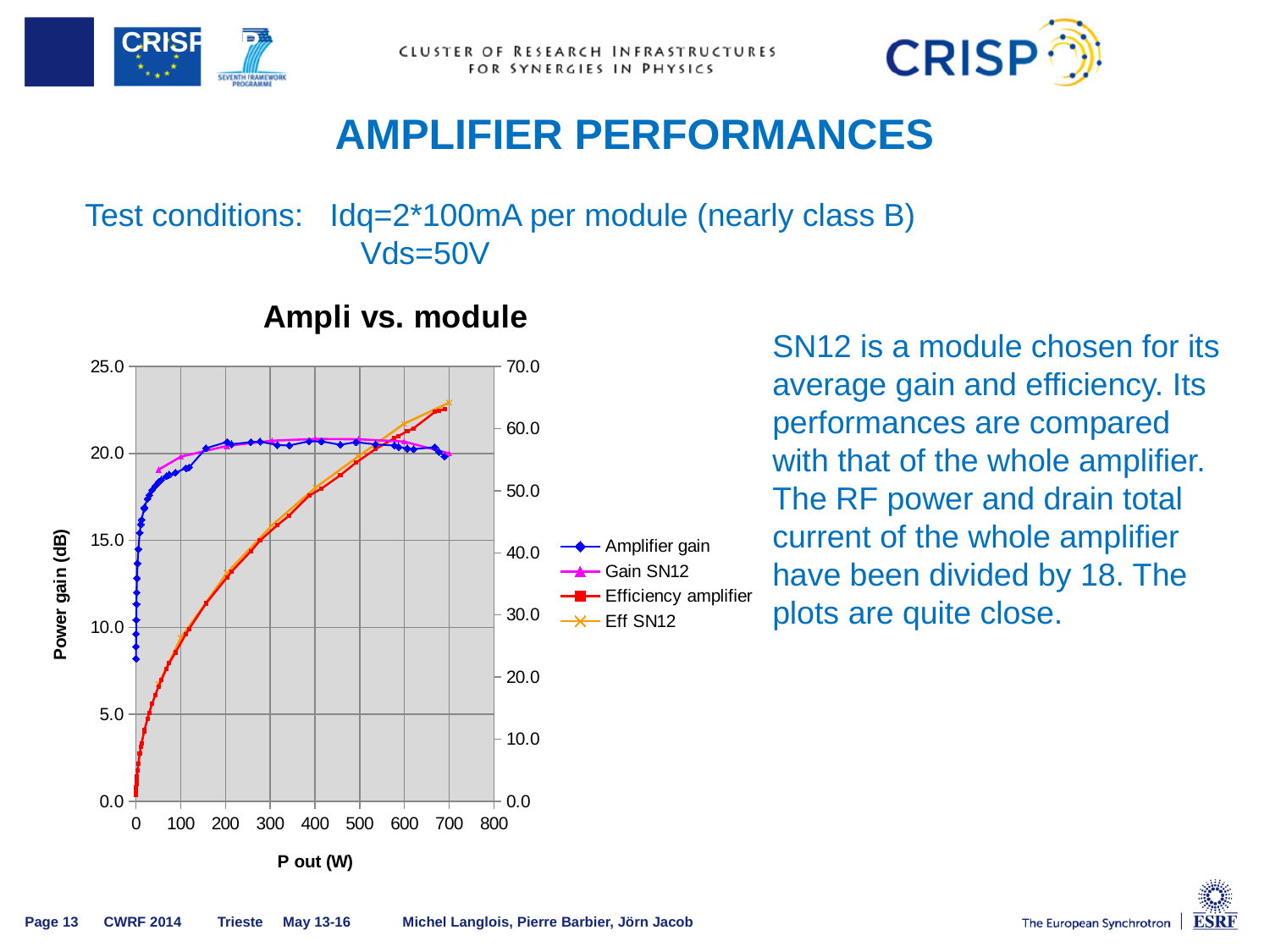
What is the title of the chart? Ampli vs. module Does the Eff SN12 series rise or fall as P out increases? rises Is the Amplifier gain value at 400 W greater or less than 15.0 dB? greater Is the Efficiency amplifier value at 700 W greater or less than 50.0 on the right axis? greater What is the label of the x axis of the chart? P out (W) Is the Gain SN12 value at 300 W greater or less than 15.0 dB? greater Does the Efficiency amplifier series rise or fall as P out increases? rises At 700 W, which is larger: the Efficiency amplifier value or the Efficiency amplifier value at 100 W? the value at 700 W What kind of chart is shown on the slide? line chart How many series does the legend of the chart list? 4